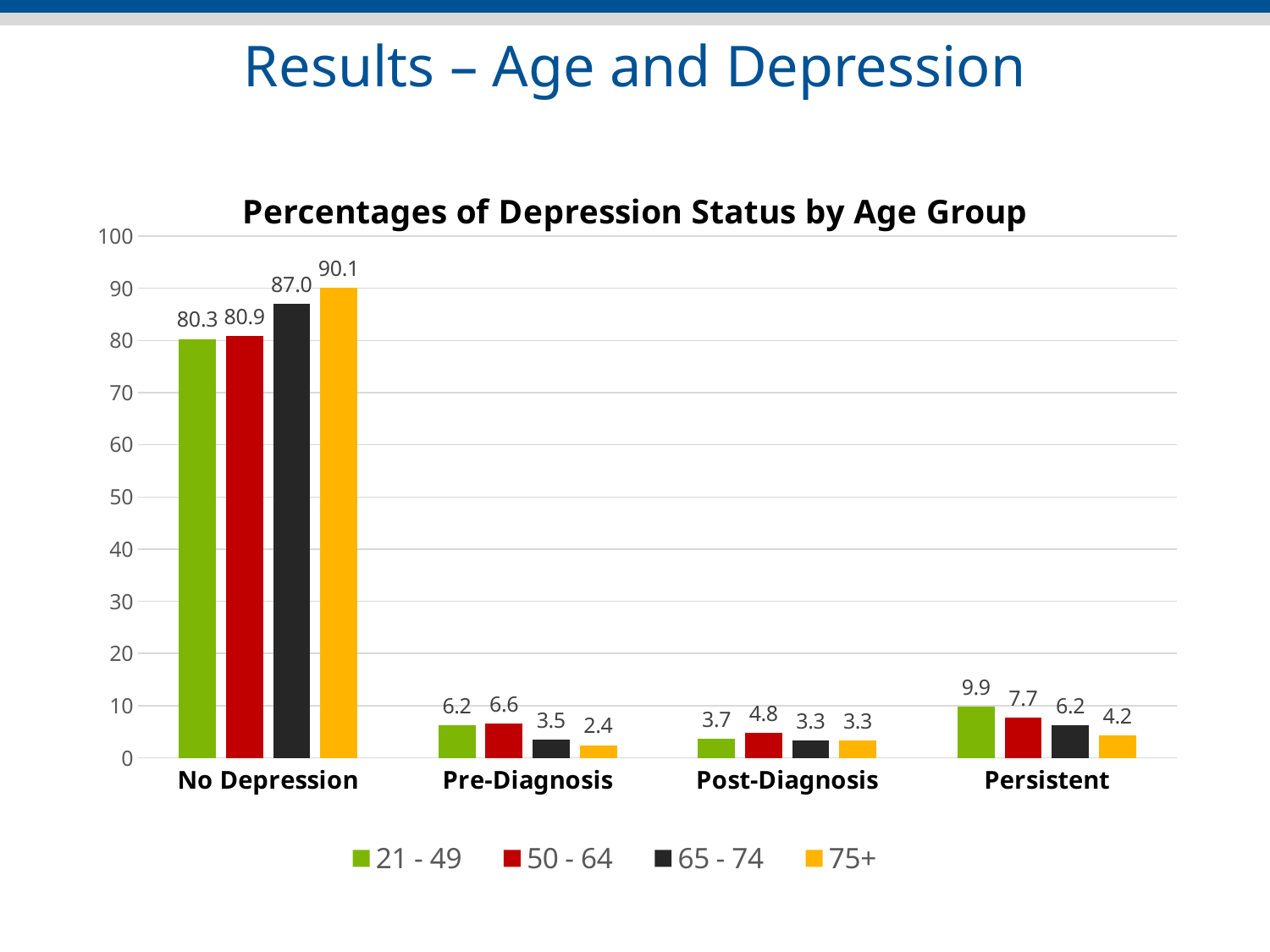
Which is larger in the Persistent category: the value for 50 - 64 or the value for 65 - 74? 50 - 64 What is the difference between the 75+ and 21 - 49 values in the No Depression category? 9.8 What is the title of the chart? Percentages of Depression Status by Age Group Which age group has the highest value in the No Depression category? 75+ What is the value for the 21 - 49 age group in the Persistent category? 9.9 What kind of chart is shown on the slide? Bar chart Which age group has the lowest value in the Pre-Diagnosis category? 75+ How many depression status categories are shown on the x axis? 4 How many age groups does the legend list? 4 Is the value for the 65 - 74 age group in the No Depression category greater or less than 80? greater What is the value for the 50 - 64 age group in the Post-Diagnosis category? 4.8 What is the value for the 75+ age group in the No Depression category? 90.1